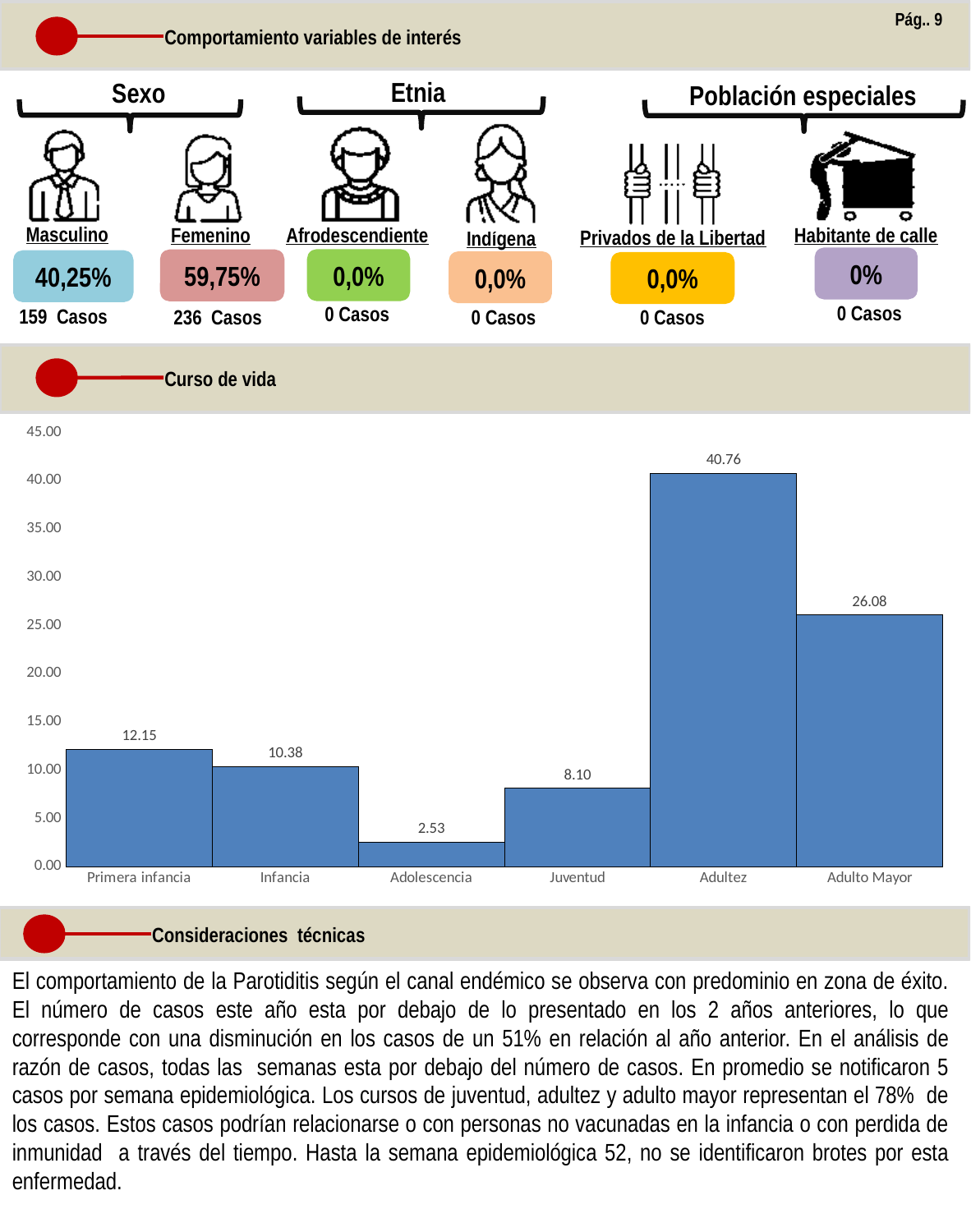
What is the value for Primera infancia in the Curso de vida chart? 12.15 Which category has the highest value in the Curso de vida chart? Adultez What is the difference between the values for Adultez and Adulto Mayor in the Curso de vida chart? 14.68 In the Curso de vida chart, which is larger: the value for Juventud or the value for Infancia? Infancia Which category has the lowest value in the Curso de vida chart? Adolescencia What is the value for Adulto Mayor in the Curso de vida chart? 26.08 What is the value for Adultez in the Curso de vida chart? 40.76 What kind of chart is the Curso de vida chart? bar chart Is the value for Adulto Mayor in the Curso de vida chart greater or less than 25.00? greater What is the difference between the values for Primera infancia and Infancia in the Curso de vida chart? 1.77 What is the value for Adolescencia in the Curso de vida chart? 2.53 How many categories are shown on the x axis of the Curso de vida chart? 6